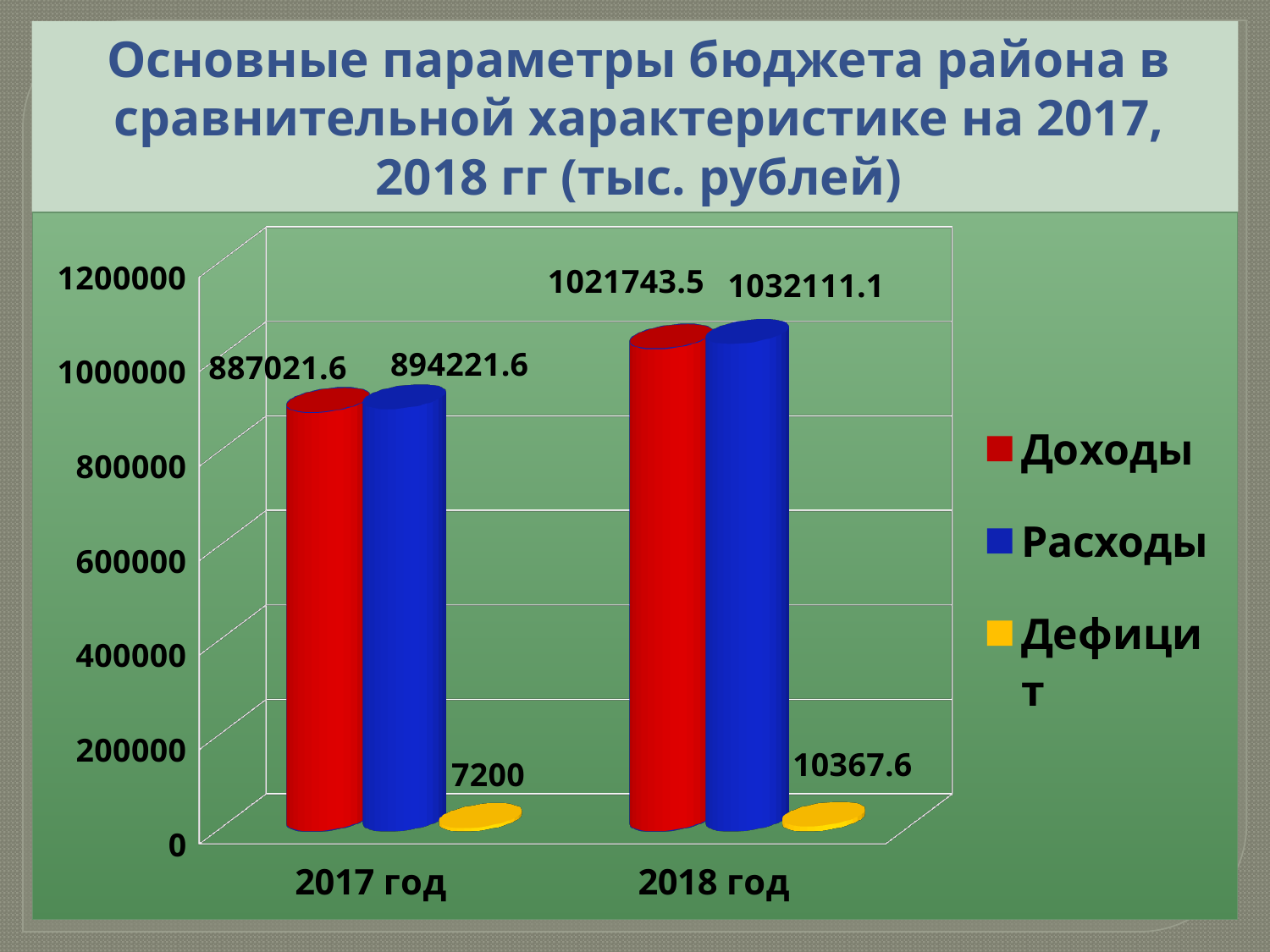
What is the value of Дефицит for 2018 год? 10367.6 What kind of chart is shown on the slide? Bar chart What is the difference between Доходы in 2018 год and Доходы in 2017 год? 134721.9 What is the value of Доходы for 2017 год? 887021.6 Which colour represents Расходы in the legend? Blue Which series has the lowest value in 2018 год? Дефицит How many series does the legend list? 3 What is the value of Расходы for 2018 год? 1032111.1 Is the value of Расходы for 2018 год greater or less than 1000000? greater What is the difference between Расходы and Доходы in 2017 год? 7200 What is the value of Дефицит for 2017 год? 7200 Which year has the higher value for Доходы? 2018 год